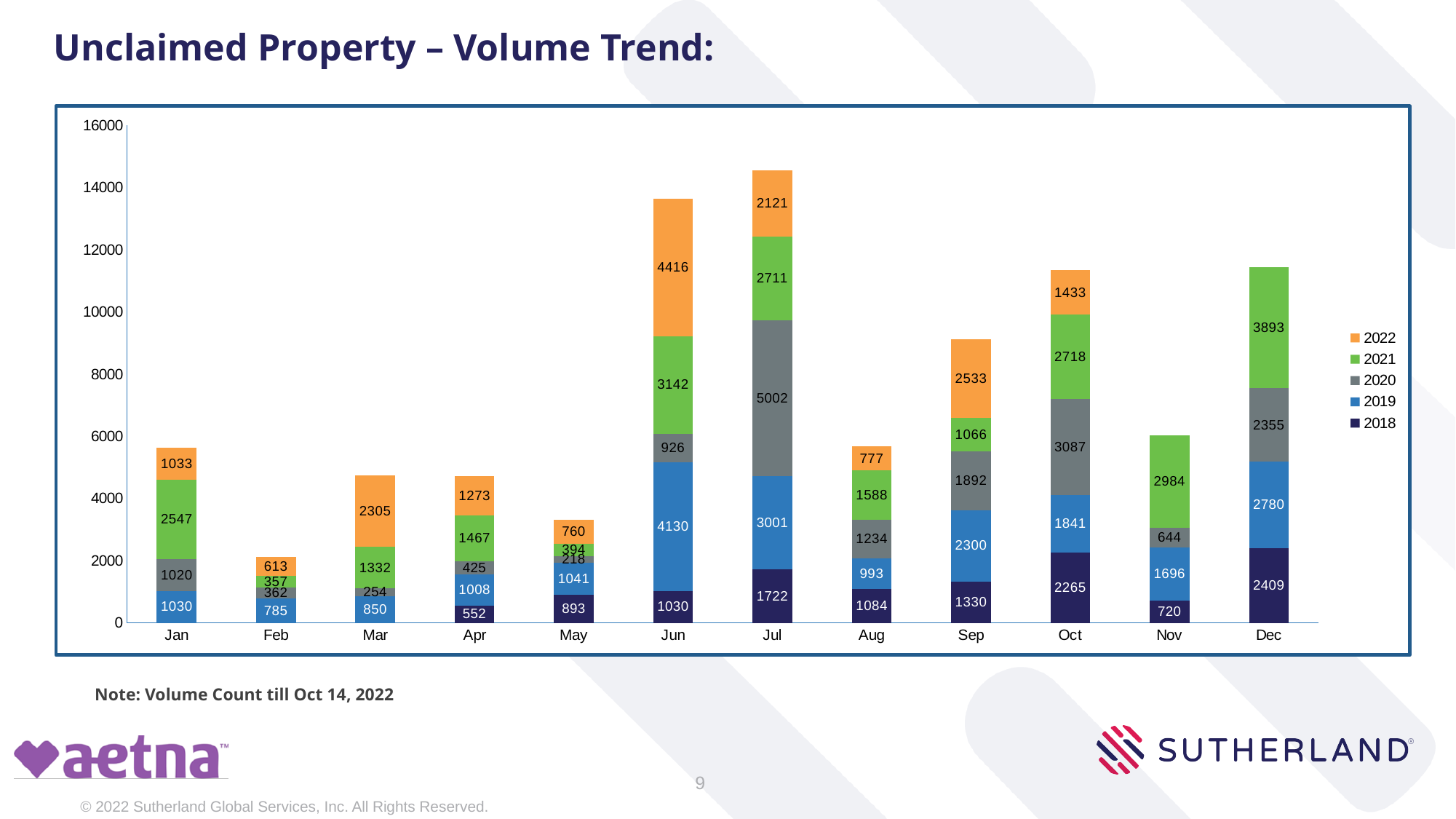
How many series does the legend list? 5 What is the value for 2022 in Jun? 4416 What is the difference between the 2021 value for Dec and the 2021 value for Nov? 909 What is the value for 2020 in Jul? 5002 Which month has the tallest stacked bar? Jul What kind of chart is shown on the slide? Stacked bar chart Which is larger, the 2019 value for Jun or the 2019 value for Jul? Jun Is the total stacked bar for Oct greater or less than 10000? greater How many months are shown on the x axis? 12 What is the total of the stacked bar for Jul? 14557 What colour represents the 2022 series in the legend? Orange Which month has the shortest stacked bar? Feb